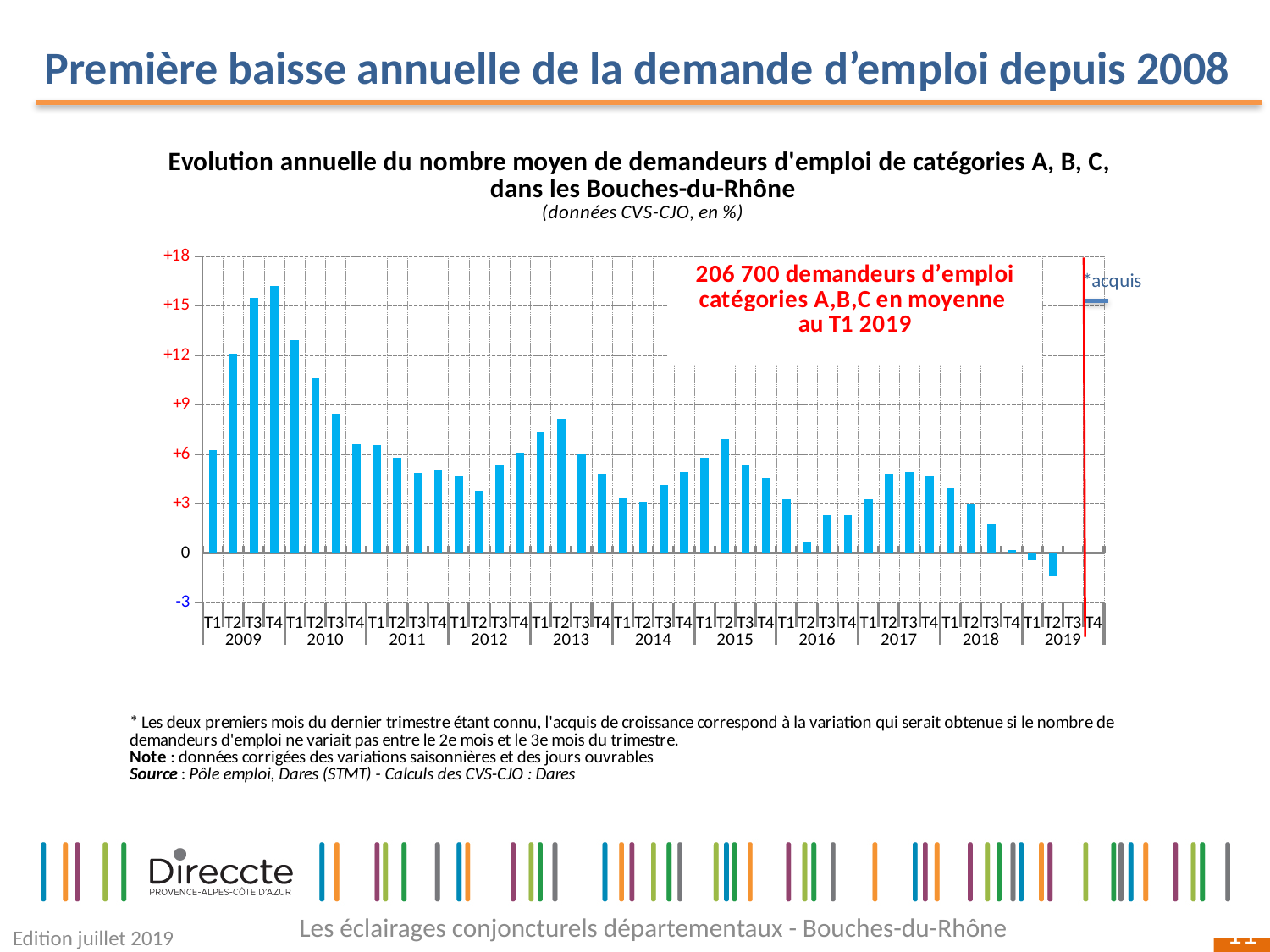
Is the value for T2 2019 greater or less than 0? less Do the values generally rise or fall from T4 2009 to T1 2012? fall Which quarter has the highest value on the chart? T4 2009 How many years are labelled on the x axis of the chart? 11 According to the annotation on the chart, how many job seekers in categories A, B, C were there on average in T1 2019? 206 700 Is the value for T3 2010 greater or less than +9? less Is the value for T2 2016 greater or less than +3? less What kind of chart is shown on the slide? bar chart Which is larger, the value for T2 2013 or the value for T2 2015? T2 2013 Which is larger, the value for T4 2009 or the value for T1 2010? T4 2009 Which quarter has the lowest value on the chart? T2 2019